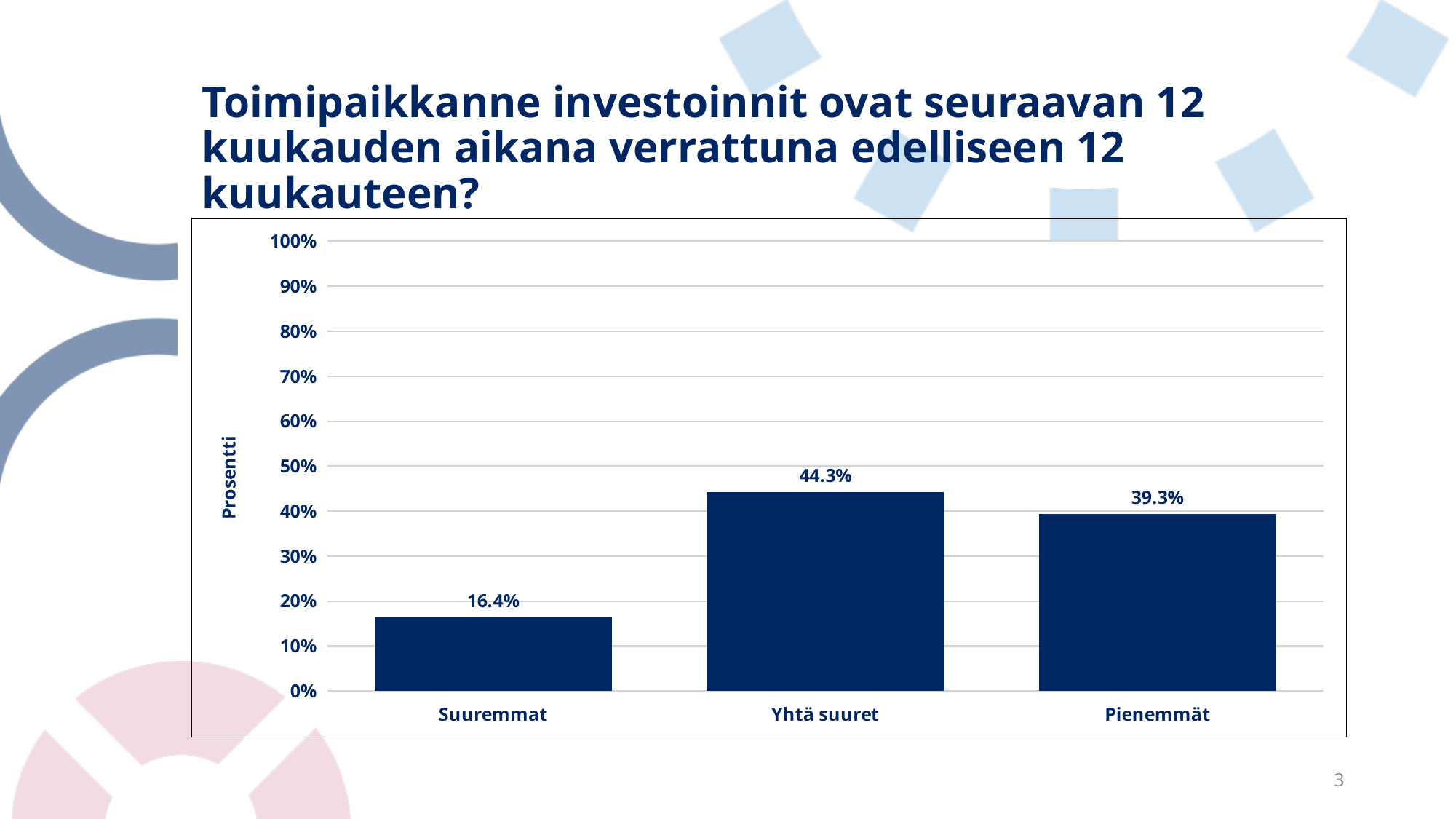
What is the difference between the values for Pienemmät and Suuremmat? 22.9% What is the difference between the values for Yhtä suuret and Pienemmät? 5.0% Which category has the highest value? Yhtä suuret How many categories are shown on the x axis? 3 Which is larger, the value for Suuremmat or the value for Pienemmät? Pienemmät What is the value for Yhtä suuret? 44.3% What is the value for Pienemmät? 39.3% What is the label of the vertical axis? Prosentti What is the value for Suuremmat? 16.4% What kind of chart is shown on the slide? bar chart Which category has the lowest value? Suuremmat Is the value for Yhtä suuret greater or less than 50%? less